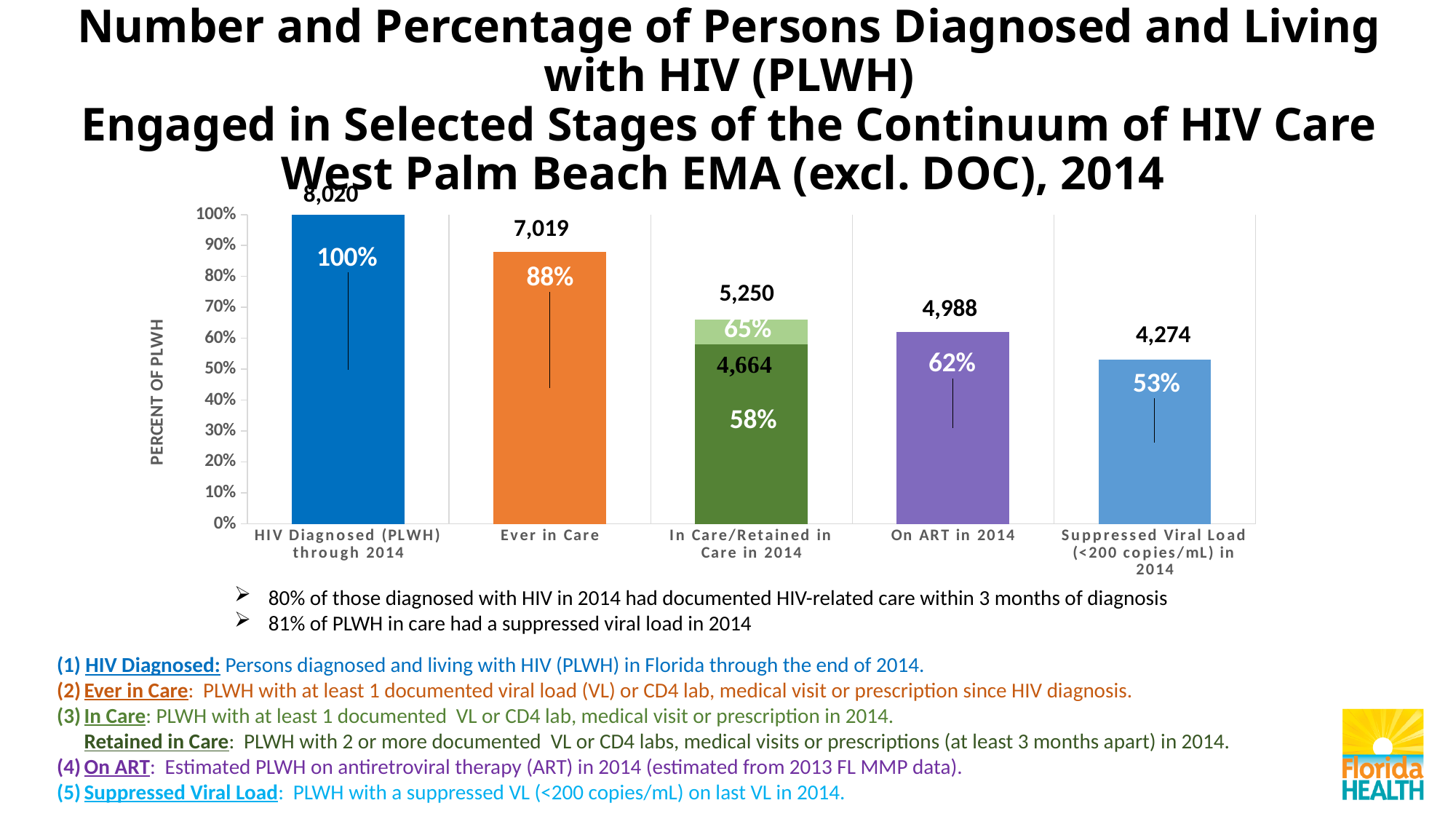
How many categories are shown on the x axis of the chart? 5 What number is printed above the 'HIV Diagnosed (PLWH) through 2014' bar? 8,020 Which category has the lowest percentage of PLWH? Suppressed Viral Load (<200 copies/mL) in 2014 What is the difference in number of persons between 'Ever in Care' (7,019) and 'On ART in 2014' (4,988)? 2,031 What percentage is shown on the 'On ART in 2014' bar? 62% What type of chart is shown on the slide? Bar chart What number is printed above the 'Ever in Care' bar? 7,019 Do the percentages generally rise or fall moving from left to right across the chart? Fall What percentage is shown for the 'Retained in Care' (darker green) portion of the 'In Care/Retained in Care in 2014' bar? 58% Which is larger: the percentage for 'Ever in Care' or the percentage for 'On ART in 2014'? Ever in Care What number is printed above the 'Suppressed Viral Load (<200 copies/mL) in 2014' bar? 4,274 Which category has the highest number of persons? HIV Diagnosed (PLWH) through 2014